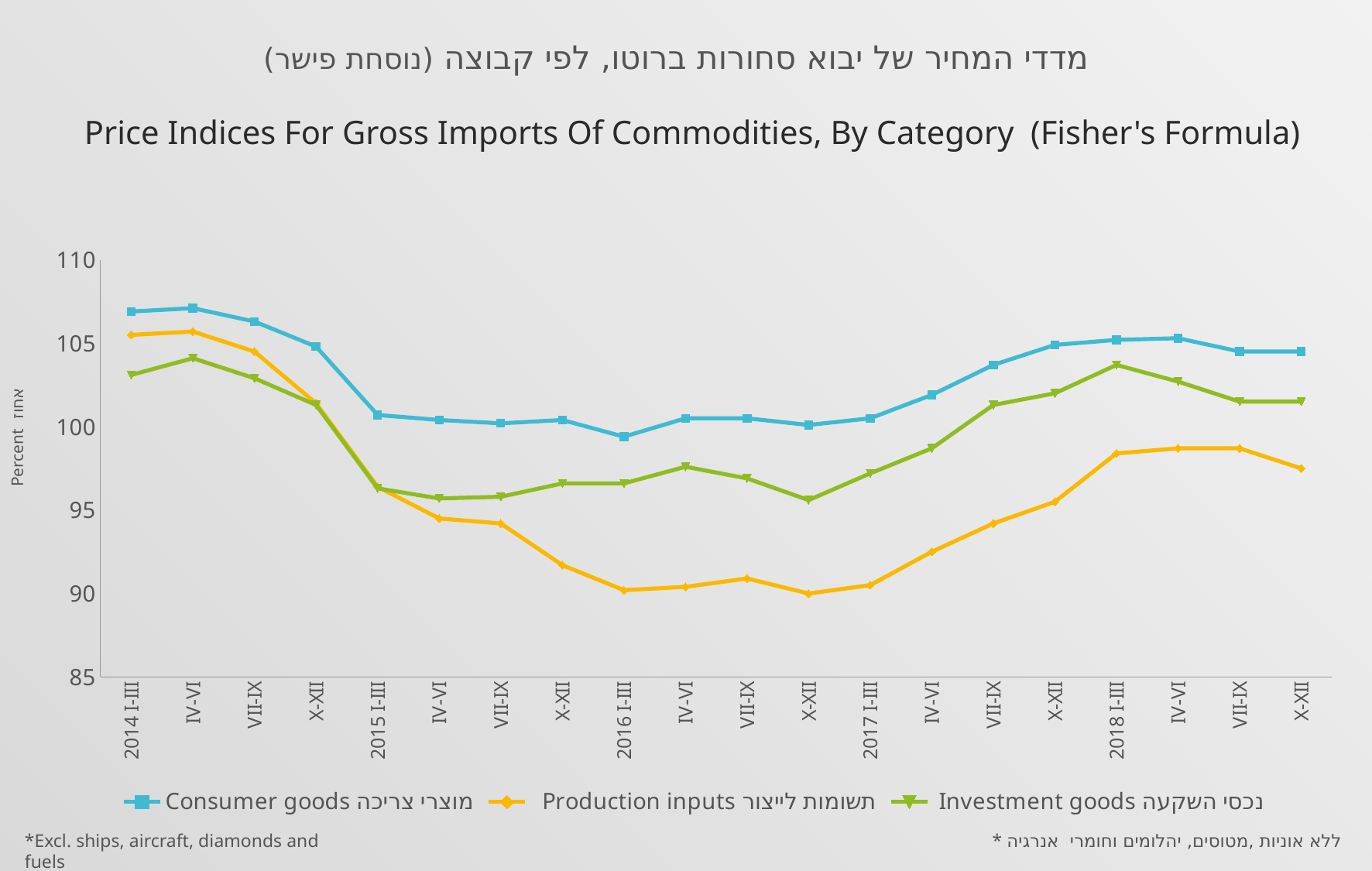
Which series has the lowest value in 2017 I-III? Production inputs Which series has the highest value in 2018 X-XII? Consumer goods What kind of chart is shown on the slide? line chart What is the English label on the y axis? Percent How many series does the legend list? 3 Is the value for Investment goods in 2018 I-III greater or less than 100? greater Do the values for Production inputs rise or fall from 2014 I-III to 2016 X-XII? fall Is the value for Consumer goods in 2014 I-III greater or less than 105? greater Is the value for Production inputs in 2015 X-XII greater or less than 95? less How many time points are plotted along the x axis? 20 In 2016 IV-VI, which is larger: Consumer goods or Production inputs? Consumer goods